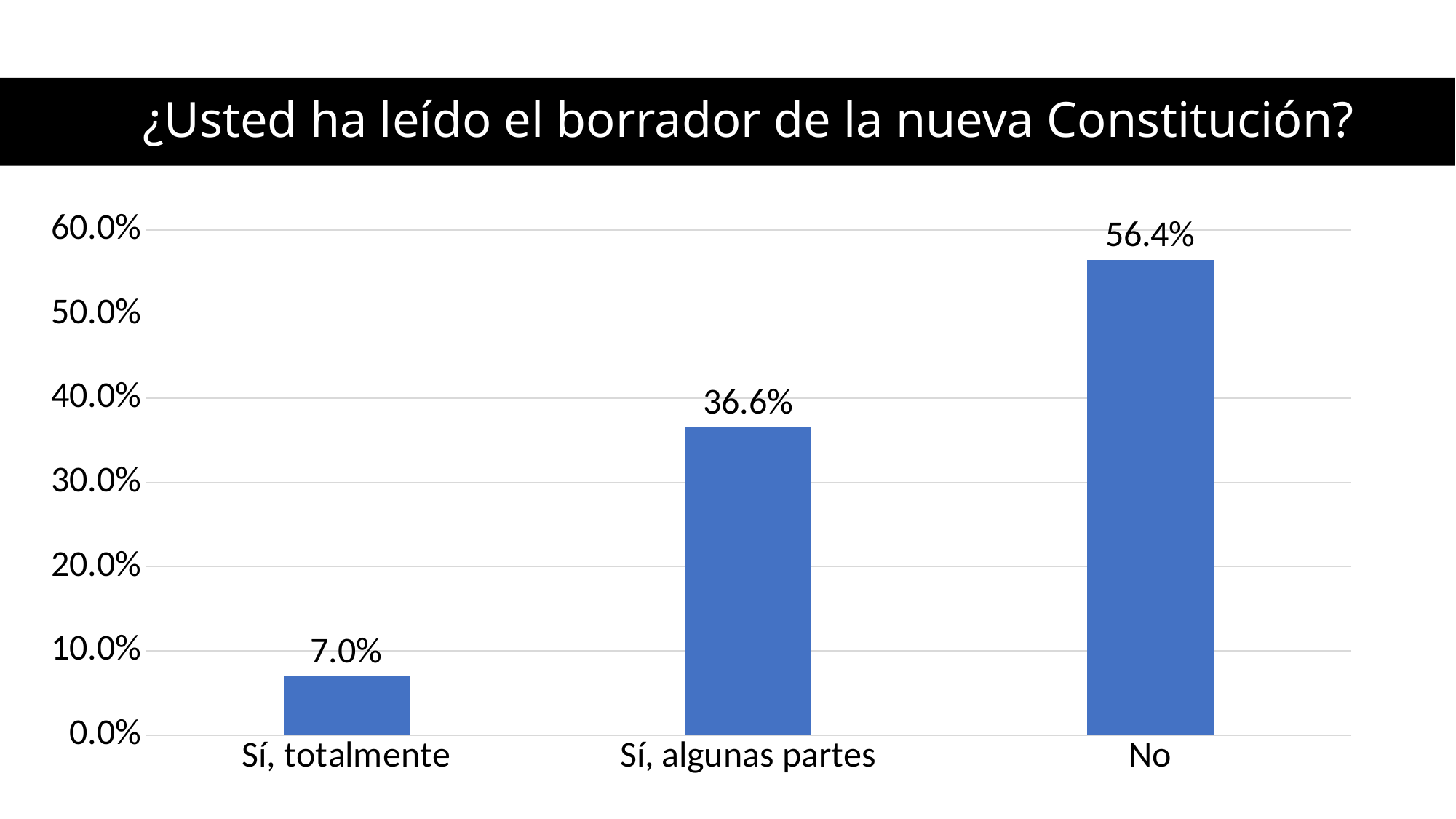
How many categories are shown on the x axis? 3 What is the value for "Sí, totalmente"? 7.0% Which is larger, the value for "Sí, totalmente" or the value for "Sí, algunas partes"? Sí, algunas partes Which category has the highest value? No What is the value for "No"? 56.4% What is the difference between the values for "No" and "Sí, algunas partes"? 19.8% What is the value for "Sí, algunas partes"? 36.6% What is the difference between the values for "Sí, algunas partes" and "Sí, totalmente"? 29.6% Is the value for "No" greater or less than 50.0%? greater Which category has the lowest value? Sí, totalmente What kind of chart is shown on the slide? bar chart What is the title of the chart? ¿Usted ha leído el borrador de la nueva Constitución?